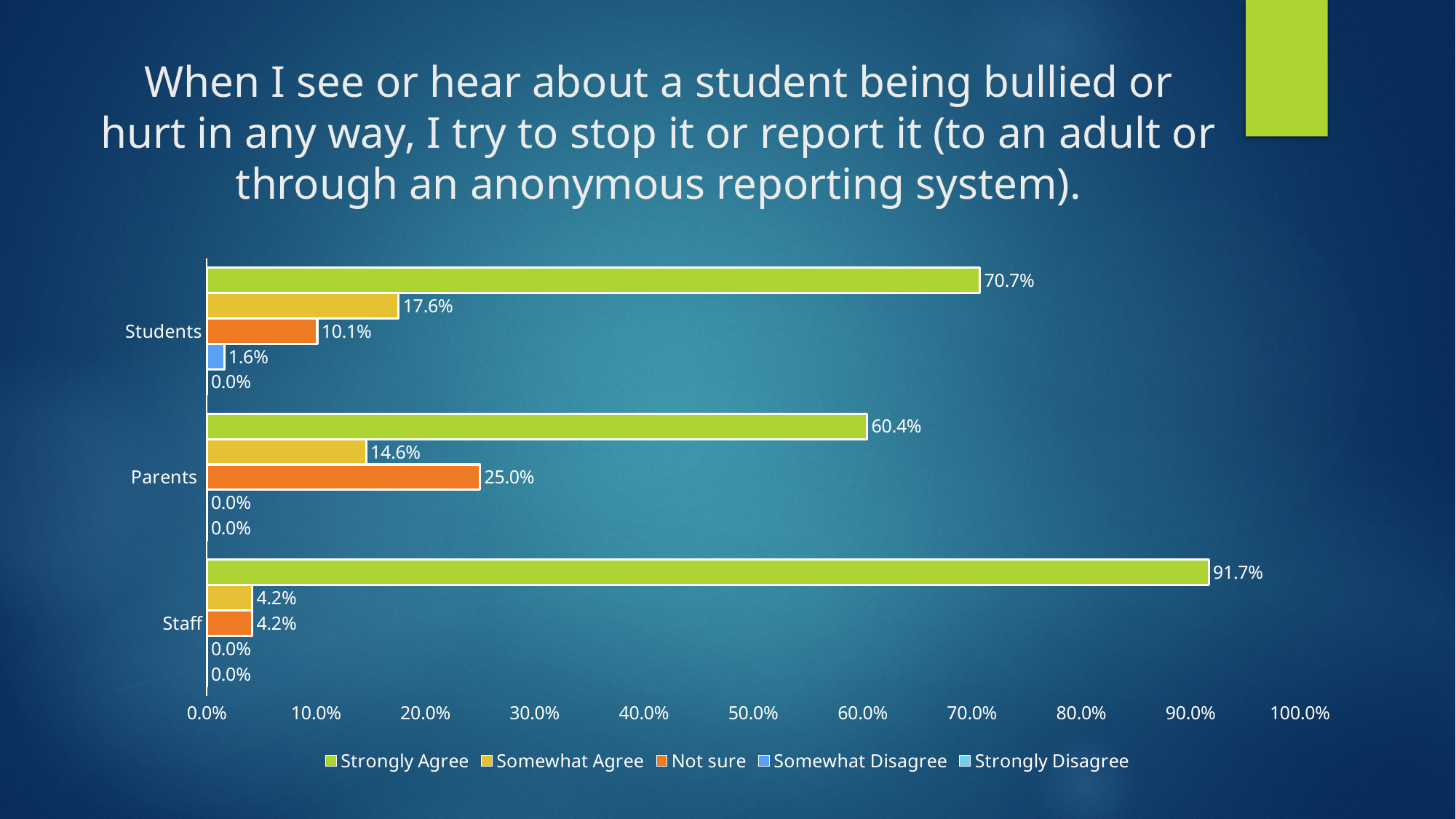
How many series does the legend list? 5 Which colour represents the Not sure series in the legend? Orange What percentage of Parents responded Not sure? 25.0% Which group has the lowest Strongly Agree percentage? Parents What percentage of Students responded Strongly Agree? 70.7% Which group has the highest Strongly Agree percentage? Staff How many groups are shown on the y axis? 3 What kind of chart is shown on the slide? Bar chart What percentage of Students responded Somewhat Disagree? 1.6% Which is larger: the Somewhat Agree percentage for Students or for Parents? Students What percentage of Staff responded Strongly Agree? 91.7% What is the difference between the Strongly Agree percentages for Staff and Students? 21.0%